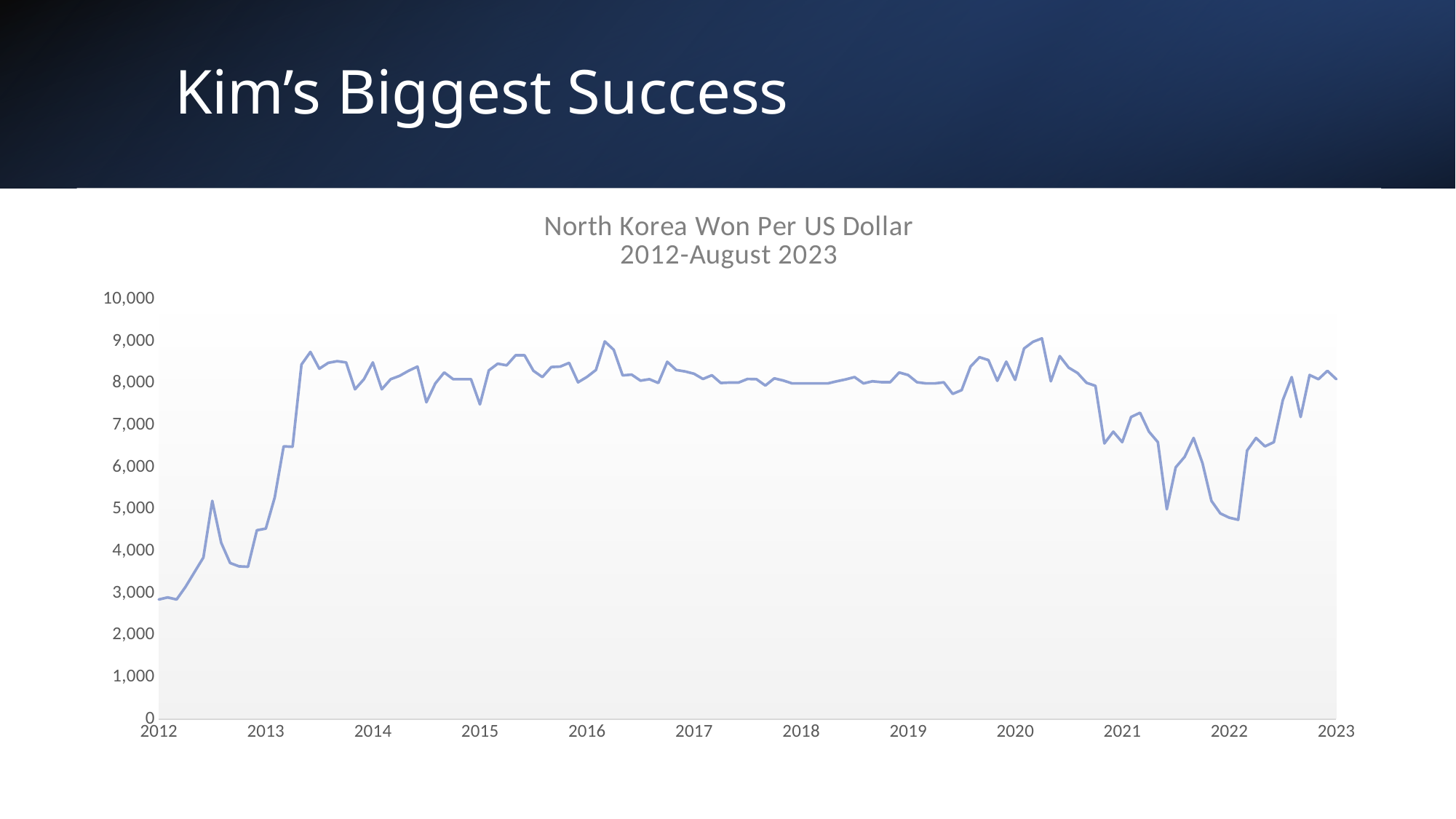
Is the value at the start of 2021 greater or less than 7,000? less Does the value rise or fall between 2012 and 2013? rise What is the highest value shown on the y axis? 10,000 Which is larger, the value at the start of 2012 or the value at the start of 2017? 2017 Does the value rise or fall between 2020 and 2022? fall What is the title of the chart? North Korea Won Per US Dollar 2012-August 2023 Is the value at the start of 2022 greater or less than 5,000? less Is the value at the start of 2013 greater or less than 4,000? greater What kind of chart is shown on the slide? line chart How many year labels are shown on the x axis? 12